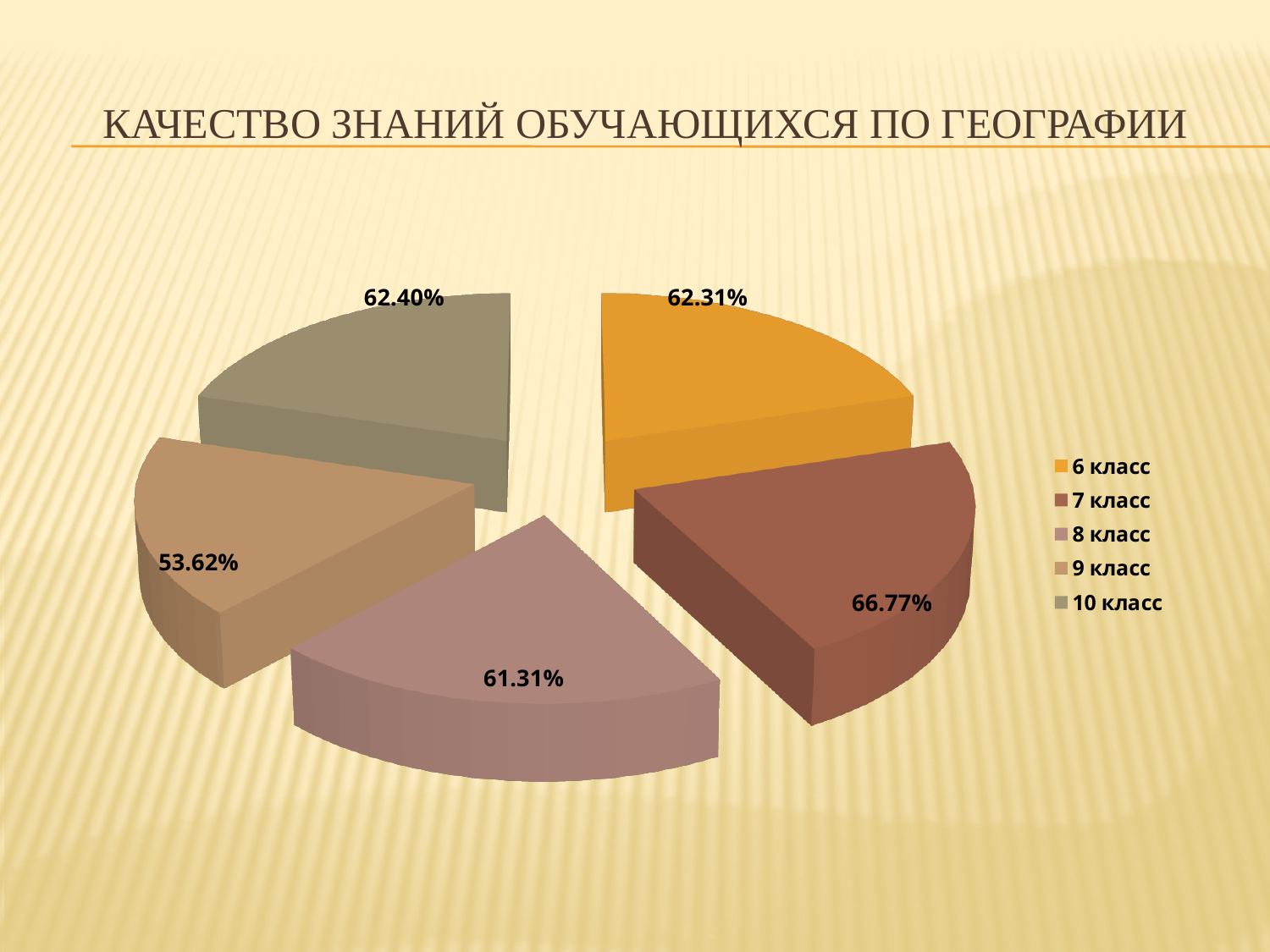
Which is larger, the value for 8 класс or the value for 7 класс? 7 класс Which class has the highest value? 7 класс What is the value for 8 класс? 61.31% What is the difference between the values for 7 класс and 9 класс? 13.15% What type of chart is shown on the slide? pie chart What is the value for 10 класс? 62.40% How many slices does the pie chart have? 5 What is the value for 9 класс? 53.62% What is the value for 7 класс? 66.77% What is the title of the slide? Качество знаний обучающихся по географии Which class has the lowest value? 9 класс What is the value for 6 класс? 62.31%